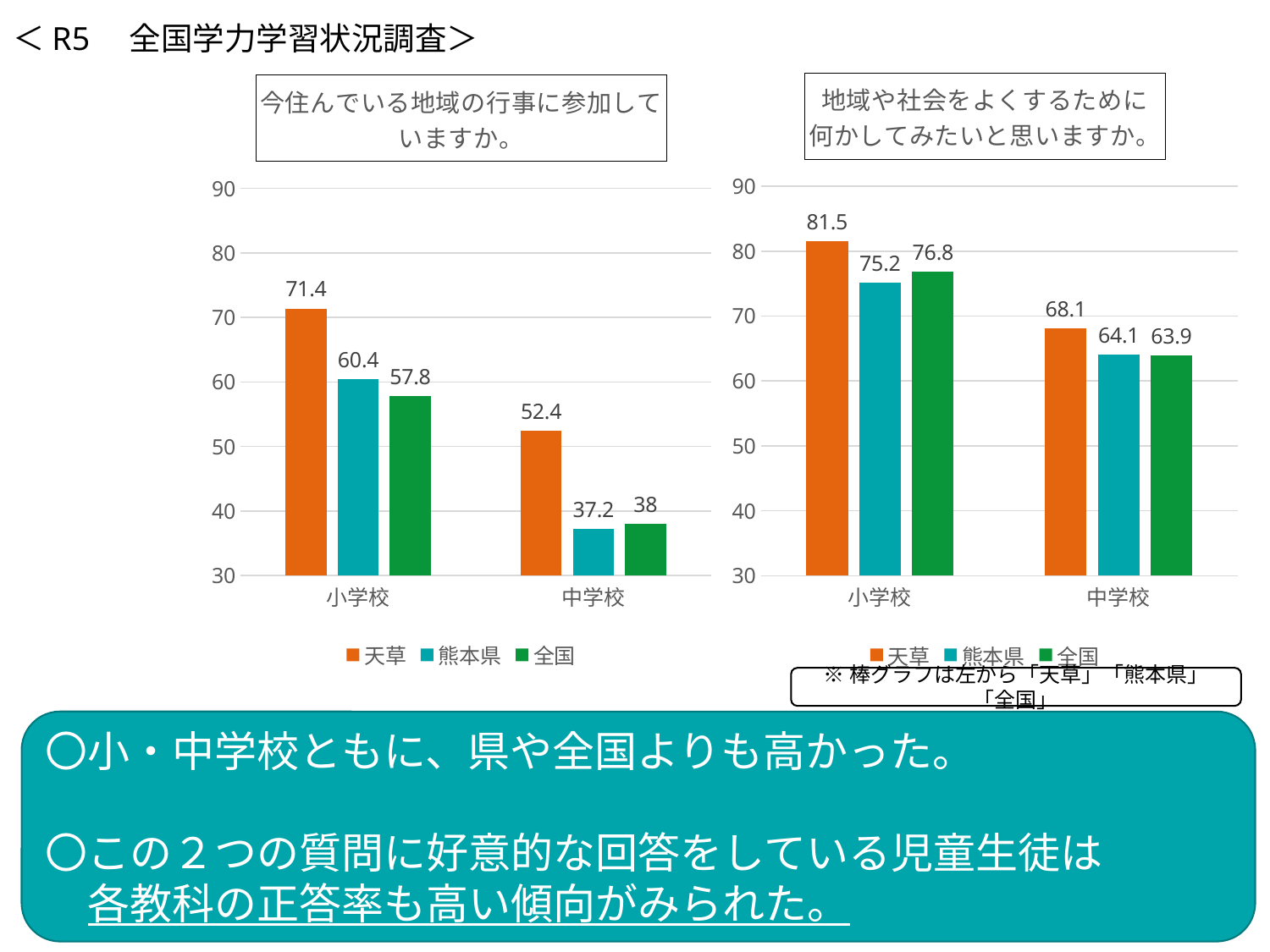
In the left chart (今住んでいる地域の行事に参加していますか。), what is the value for 天草 in the 小学校 category? 71.4 What kind of chart is the right chart (地域や社会をよくするために何かしてみたいと思いますか。)? Bar chart In the right chart (地域や社会をよくするために何かしてみたいと思いますか。), which series has the highest value in the 小学校 category? 天草 How many series does the legend of the left chart list? 3 In the left chart (今住んでいる地域の行事に参加していますか。), does the 天草 value fall or rise from 小学校 to 中学校? Fall In the left chart (今住んでいる地域の行事に参加していますか。), which series has the lowest value in the 中学校 category? 熊本県 In the left chart (今住んでいる地域の行事に参加していますか。), what is the value for 熊本県 in the 中学校 category? 37.2 In the right chart (地域や社会をよくするために何かしてみたいと思いますか。), what is the difference between the 天草 and 熊本県 values in the 中学校 category? 4 In the left chart (今住んでいる地域の行事に参加していますか。), what is the difference between the 天草 and 全国 values in the 小学校 category? 13.6 In the right chart (地域や社会をよくするために何かしてみたいと思いますか。), which is larger in the 小学校 category: 熊本県 or 全国? 全国 In the right chart (地域や社会をよくするために何かしてみたいと思いますか。), what is the value for 全国 in the 小学校 category? 76.8 In the right chart (地域や社会をよくするために何かしてみたいと思いますか。), what is the value for 天草 in the 中学校 category? 68.1